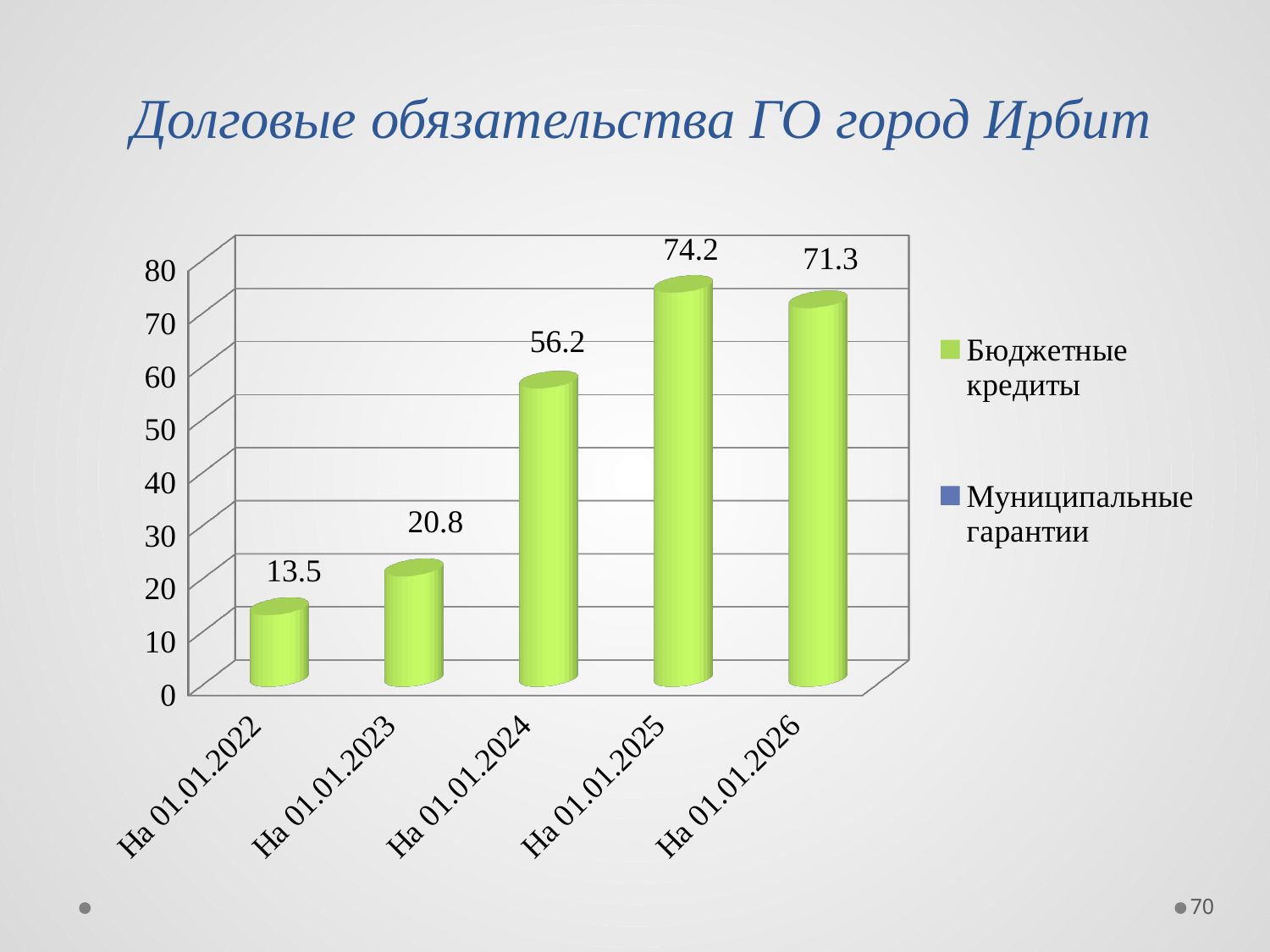
Which date has the lowest value for Бюджетные кредиты? На 01.01.2022 Is the value for На 01.01.2025 greater or less than 70? greater What is the difference between the values for На 01.01.2024 and На 01.01.2023? 35.4 How many series does the legend list? 2 What is the value for Бюджетные кредиты on На 01.01.2022? 13.5 How many dates are shown on the x axis? 5 What is the value for Бюджетные кредиты on На 01.01.2024? 56.2 What kind of chart is shown on the slide? bar chart Which is larger, the value for На 01.01.2023 or the value for На 01.01.2024? На 01.01.2024 What is the difference between the values for На 01.01.2025 and На 01.01.2026? 2.9 What is the value for Бюджетные кредиты on На 01.01.2026? 71.3 Which date has the highest value for Бюджетные кредиты? На 01.01.2025